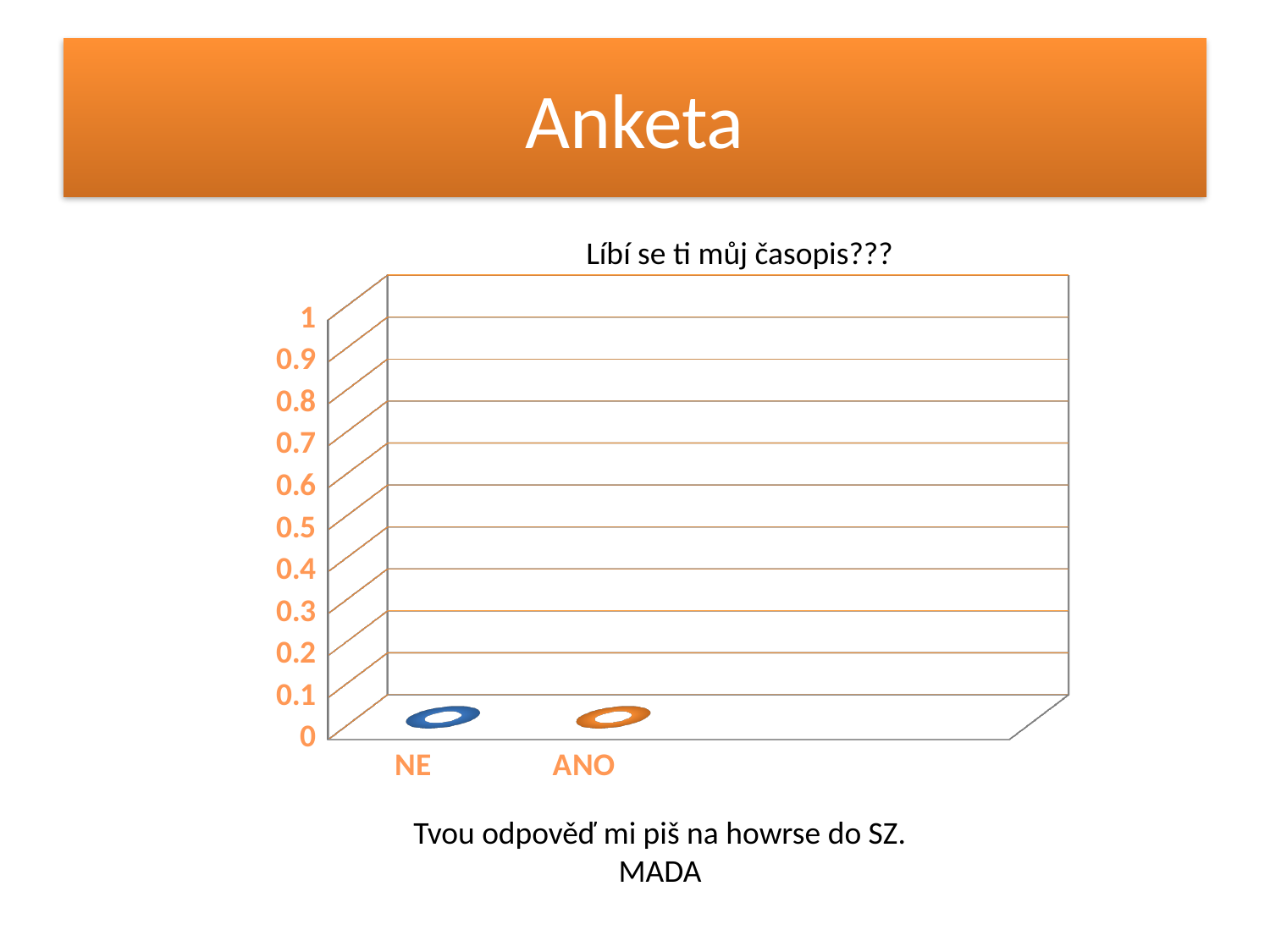
What is the value for ANO in the chart? 0 What kind of chart is shown on the slide? bar chart How many categories are shown on the x axis of the chart? 2 What colour is the bar for ANO? orange What is the title of the chart? Líbí se ti můj časopis??? What is the value for NE in the chart? 0 Is the value for NE greater or less than 0.5? less What is the difference between the values for NE and ANO? 0 Is the value for ANO greater or less than 0.1? less